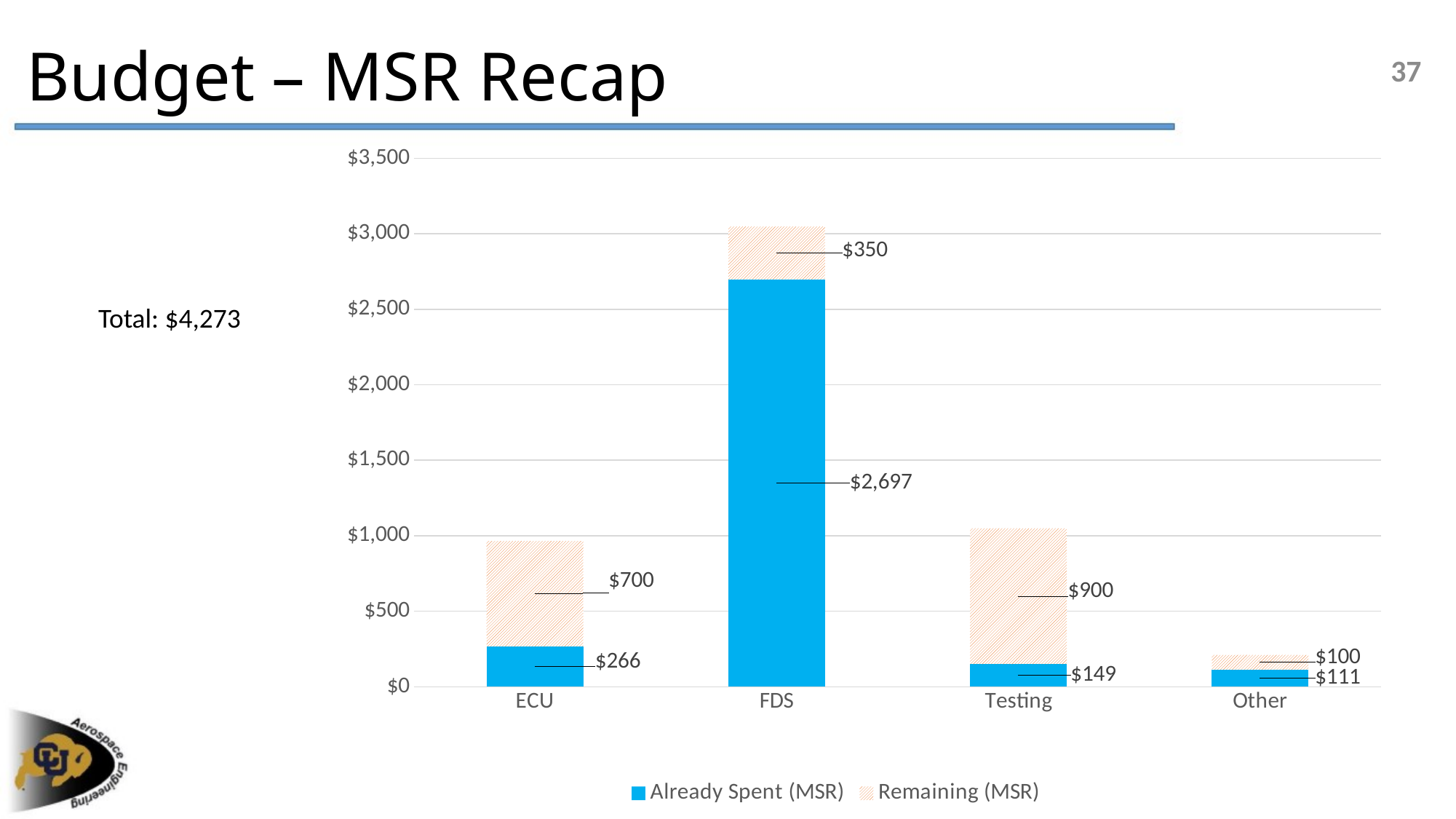
What is the total of the stacked bar for FDS? $3,047 Which category has the highest Already Spent (MSR) value? FDS Which category has the lowest Remaining (MSR) value? Other What is the Remaining (MSR) value for Other? $100 What is the Remaining (MSR) value for Testing? $900 What is the Already Spent (MSR) value for FDS? $2,697 How many categories are shown on the x axis of the chart? 4 What is the Already Spent (MSR) value for ECU? $266 How many series does the chart legend list? 2 Which is larger, the Already Spent (MSR) value for Testing or for Other? Testing What type of chart is shown on the slide? Stacked bar chart What is the difference between the Remaining (MSR) values for Testing and ECU? $200